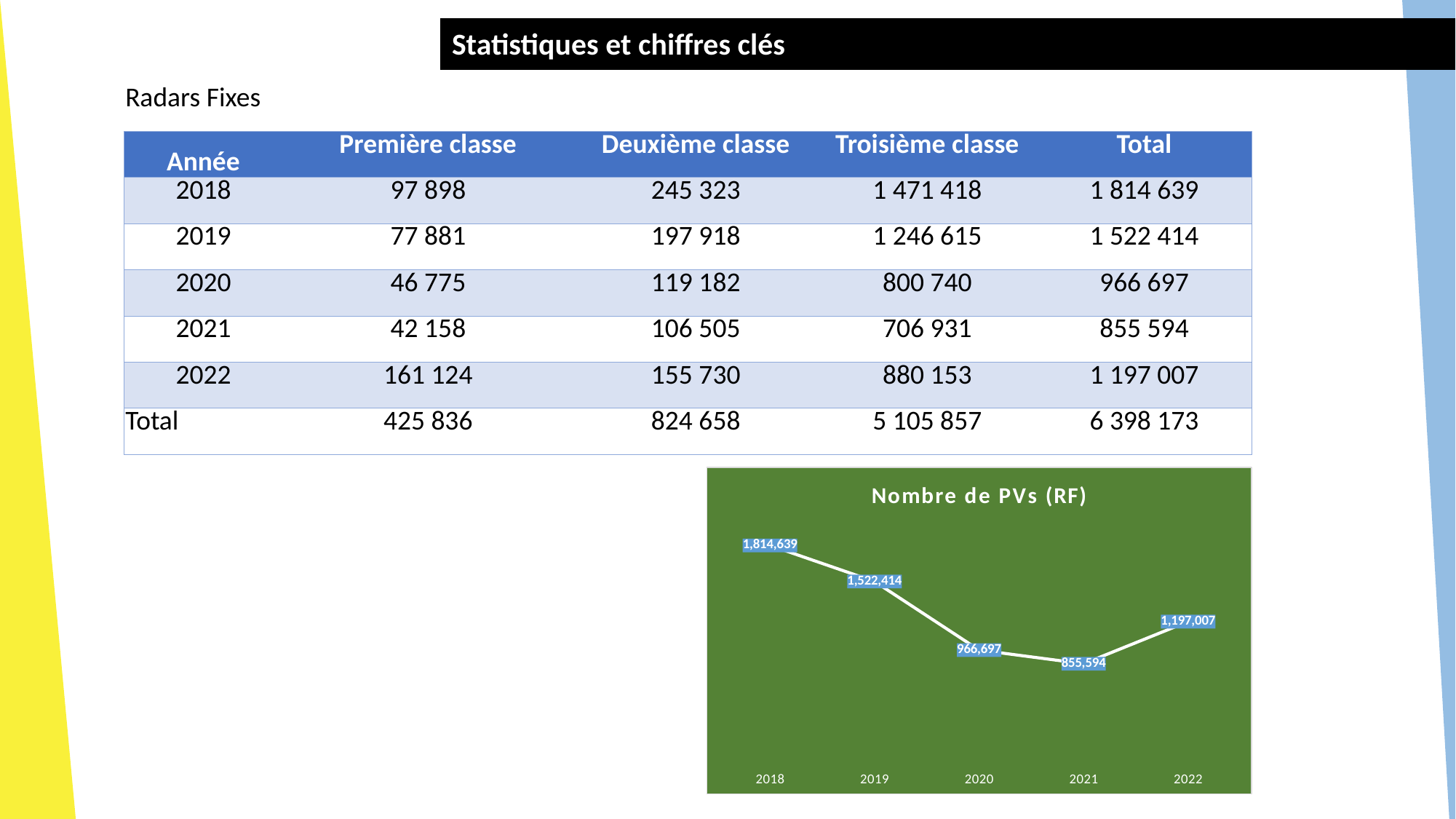
What is the difference between the 2018 and 2019 values in the "Nombre de PVs (RF)" chart? 292,225 What is the value for 2018 in the "Nombre de PVs (RF)" chart? 1,814,639 What is the title of the chart on the slide? Nombre de PVs (RF) How many years are plotted in the "Nombre de PVs (RF)" chart? 5 In the "Nombre de PVs (RF)" chart, is the value for 2020 or 2022 larger? 2022 Does the line in the "Nombre de PVs (RF)" chart rise or fall from 2018 to 2021? fall Which year has the lowest value in the "Nombre de PVs (RF)" chart? 2021 What is the value for 2021 in the "Nombre de PVs (RF)" chart? 855,594 What is the value for 2022 in the "Nombre de PVs (RF)" chart? 1,197,007 What type of chart is "Nombre de PVs (RF)"? line chart Which year has the highest value in the "Nombre de PVs (RF)" chart? 2018 What is the difference between the 2022 and 2021 values in the "Nombre de PVs (RF)" chart? 341,413